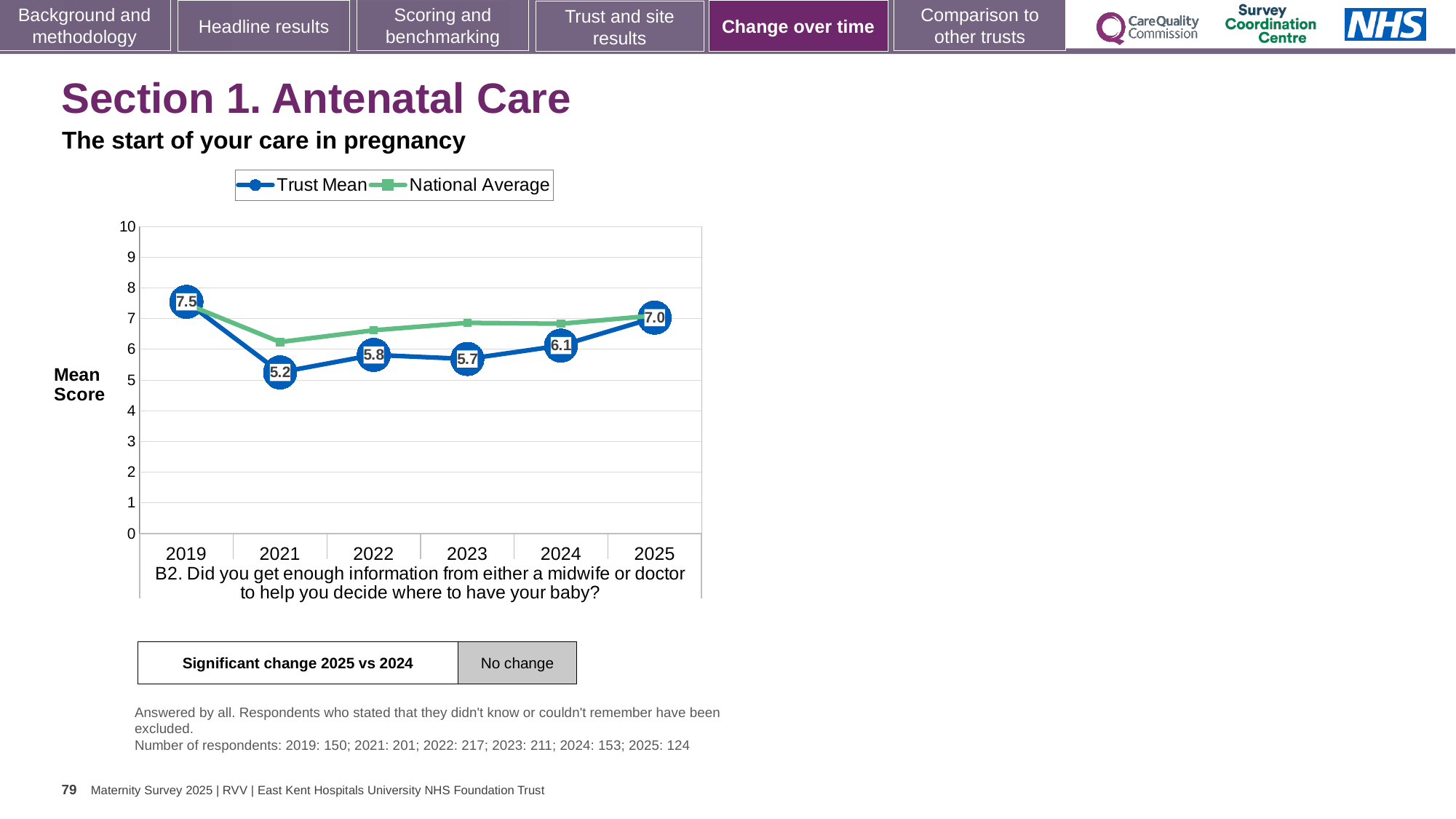
What is the Trust Mean score for 2025? 7.0 In which year is the Trust Mean score lowest? 2021 In which year is the Trust Mean score highest? 2019 By how much did the Trust Mean score change from 2024 to 2025? 0.9 Which year has the larger Trust Mean score, 2022 or 2023? 2022 What is the Trust Mean score for 2023? 5.7 What kind of chart is shown on the slide? line chart How many years are shown on the x axis? 6 What is the difference between the Trust Mean scores for 2019 and 2021? 2.3 Is the National Average value for 2021 greater or less than 7? less What is the Trust Mean score for 2019? 7.5 How many series does the legend list? 2